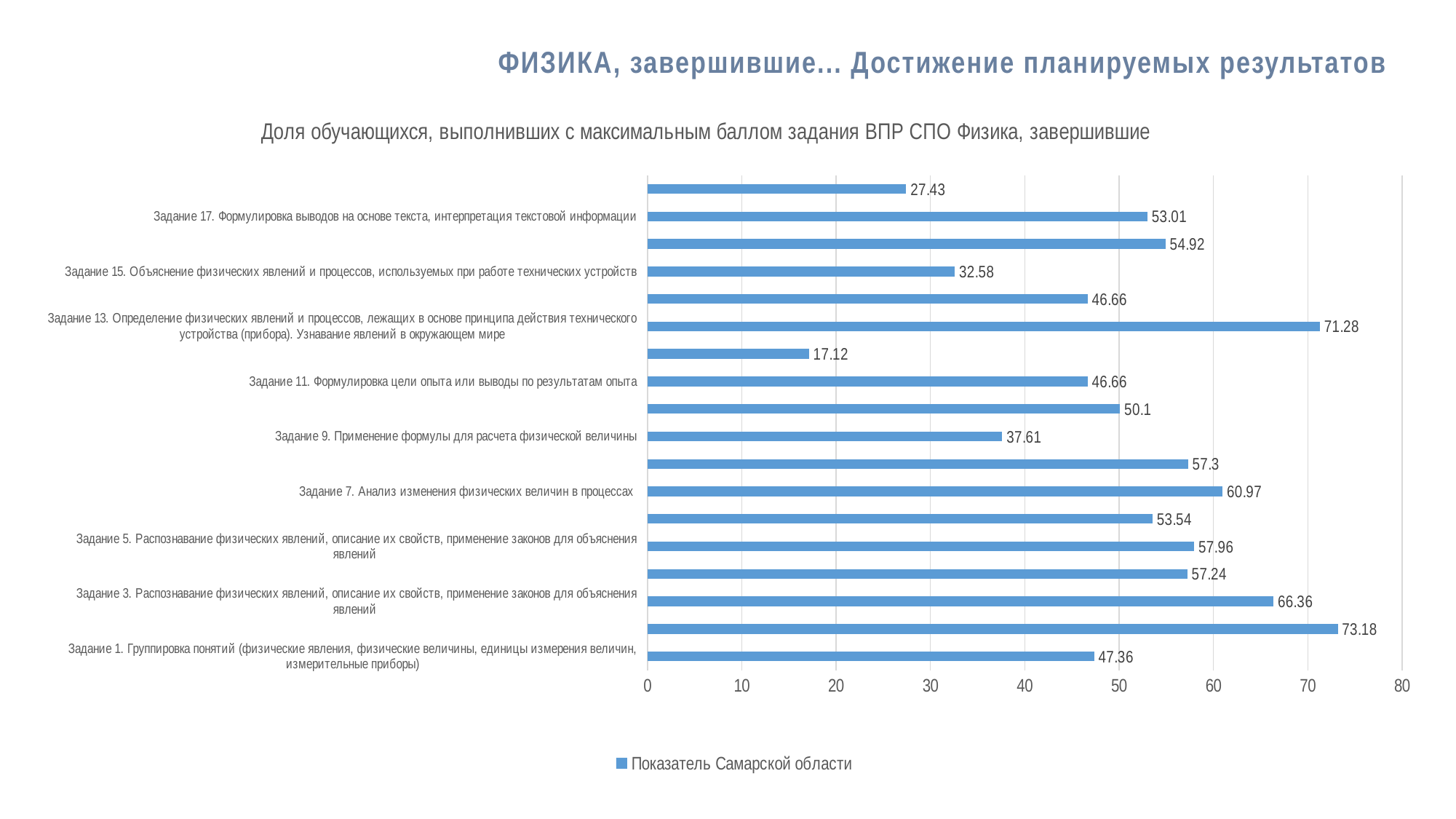
What type of chart is shown on the slide? bar chart What is the largest value shown on the chart? 73.18 What is the smallest value shown on the chart? 17.12 Which has a larger value: Задание 3 or Задание 1? Задание 3 What is the difference between the values for Задание 13 and Задание 15? 38.7 Is the value for Задание 11 greater or less than 40? greater How many bars are plotted on the chart? 18 What is the value for Задание 15 (Объяснение физических явлений и процессов...)? 32.58 What is the value for Задание 17 (Формулировка выводов на основе текста...)? 53.01 What is the value for Задание 13 (Определение физических явлений и процессов...)? 71.28 What is the name of the series listed in the legend? Показатель Самарской области What is the value for Задание 1 (Группировка понятий)? 47.36